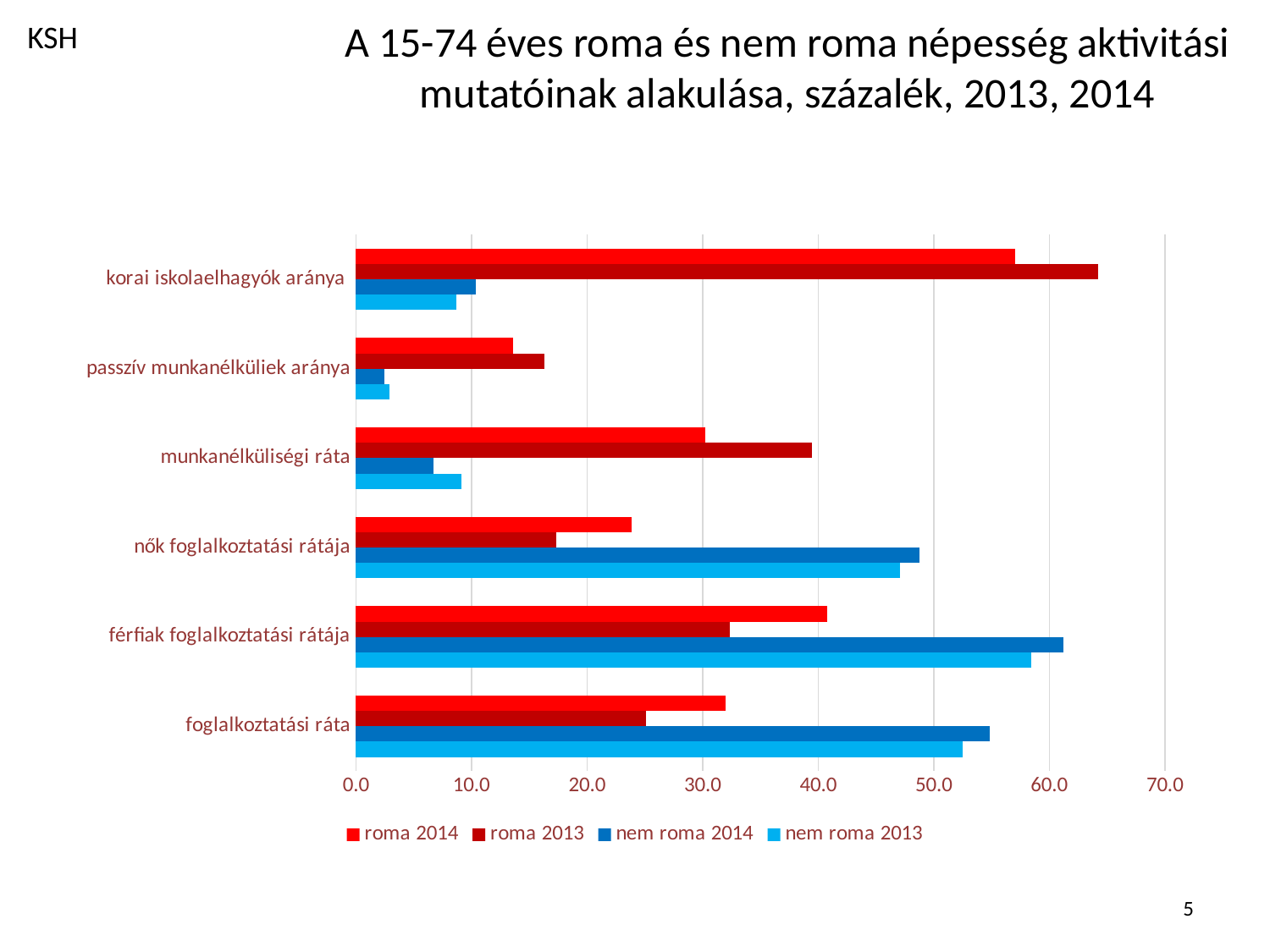
For munkanélküliségi ráta, which is larger: the roma 2013 value or the roma 2014 value? roma 2013 For nők foglalkoztatási rátája, which is larger: the roma 2014 value or the roma 2013 value? roma 2014 Is the roma 2013 value for korai iskolaelhagyók aránya greater or less than 60.0? greater How many series does the legend list? 4 Is the nem roma 2013 value for foglalkoztatási ráta greater or less than 50.0? greater Is the roma 2014 value for munkanélküliségi ráta greater or less than 40.0? less How many categories are shown on the vertical axis of the chart? 6 For which category is the roma 2013 value the highest? korai iskolaelhagyók aránya Which series is shown in light blue in the legend? nem roma 2013 What is the title of the chart on the slide? A 15-74 éves roma és nem roma népesség aktivitási mutatóinak alakulása, százalék, 2013, 2014 For which category is the nem roma 2014 value the lowest? passzív munkanélküliek aránya What kind of chart is shown on the slide? bar chart